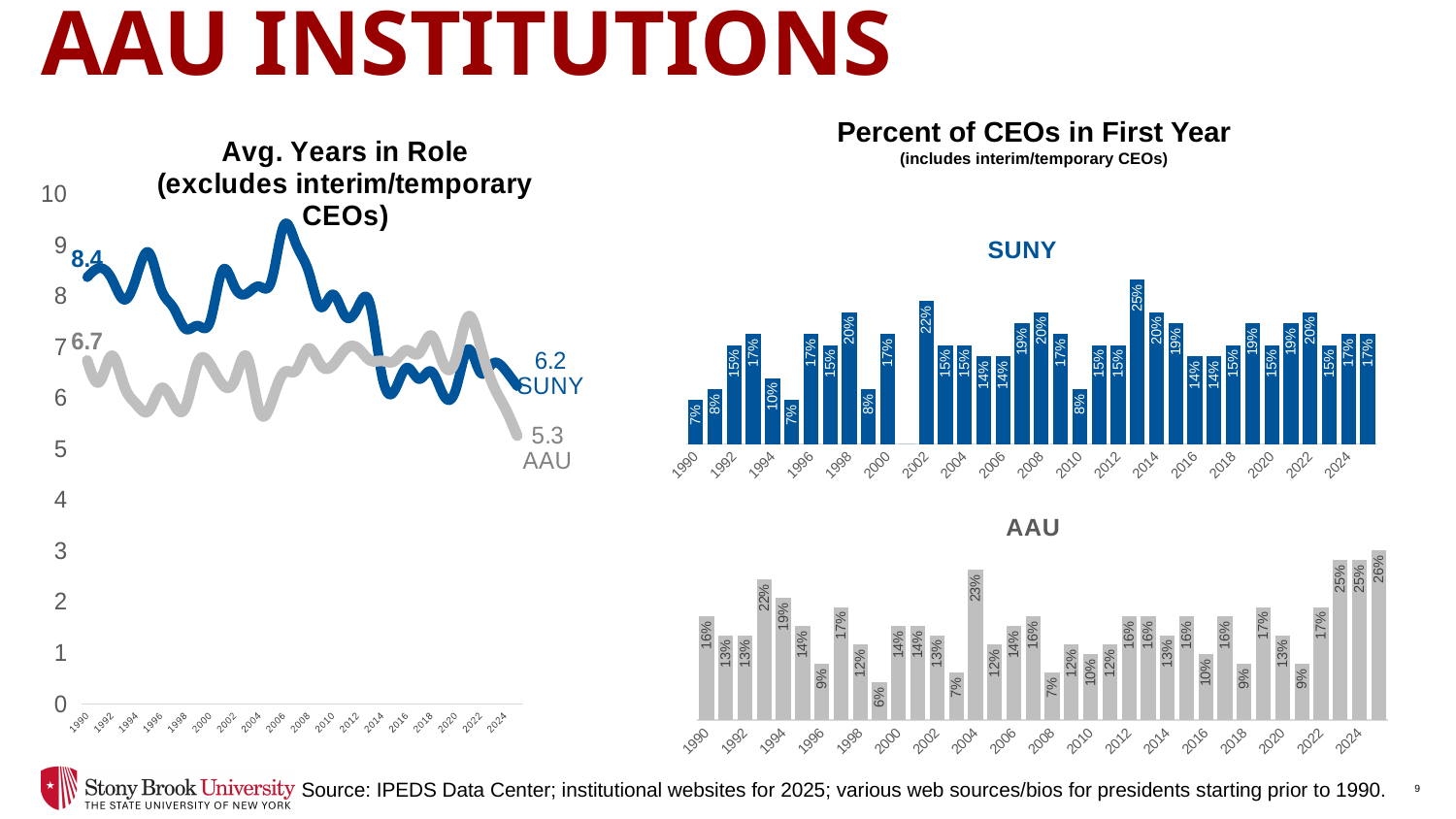
In the 'Avg. Years in Role' chart, what is the difference between the final SUNY value and the final AAU value? 0.9 In the 'Avg. Years in Role' chart, what is the most recent SUNY value shown at the end of the line? 6.2 What kind of chart is the 'Avg. Years in Role' chart on the left of the slide? Line chart In the 'Avg. Years in Role' chart, what is the AAU value at the start of the series in 1990? 6.7 In the 'Avg. Years in Role' chart, what is the SUNY value at the start of the series in 1990? 8.4 In the 'Percent of CEOs in First Year' AAU bar chart, what is the highest value shown? 26% In the 'Avg. Years in Role' chart, which series has the higher value at the end of the period, SUNY or AAU? SUNY In the 'Avg. Years in Role' chart, what is the most recent AAU value shown at the end of the line? 5.3 How many series are plotted in the 'Avg. Years in Role' chart? 2 In the 'Percent of CEOs in First Year' AAU bar chart, what is the lowest value shown? 6% In the 'Percent of CEOs in First Year' SUNY bar chart, what is the highest value shown? 25% In the 'Percent of CEOs in First Year' SUNY bar chart, what is the value for 1990? 7%